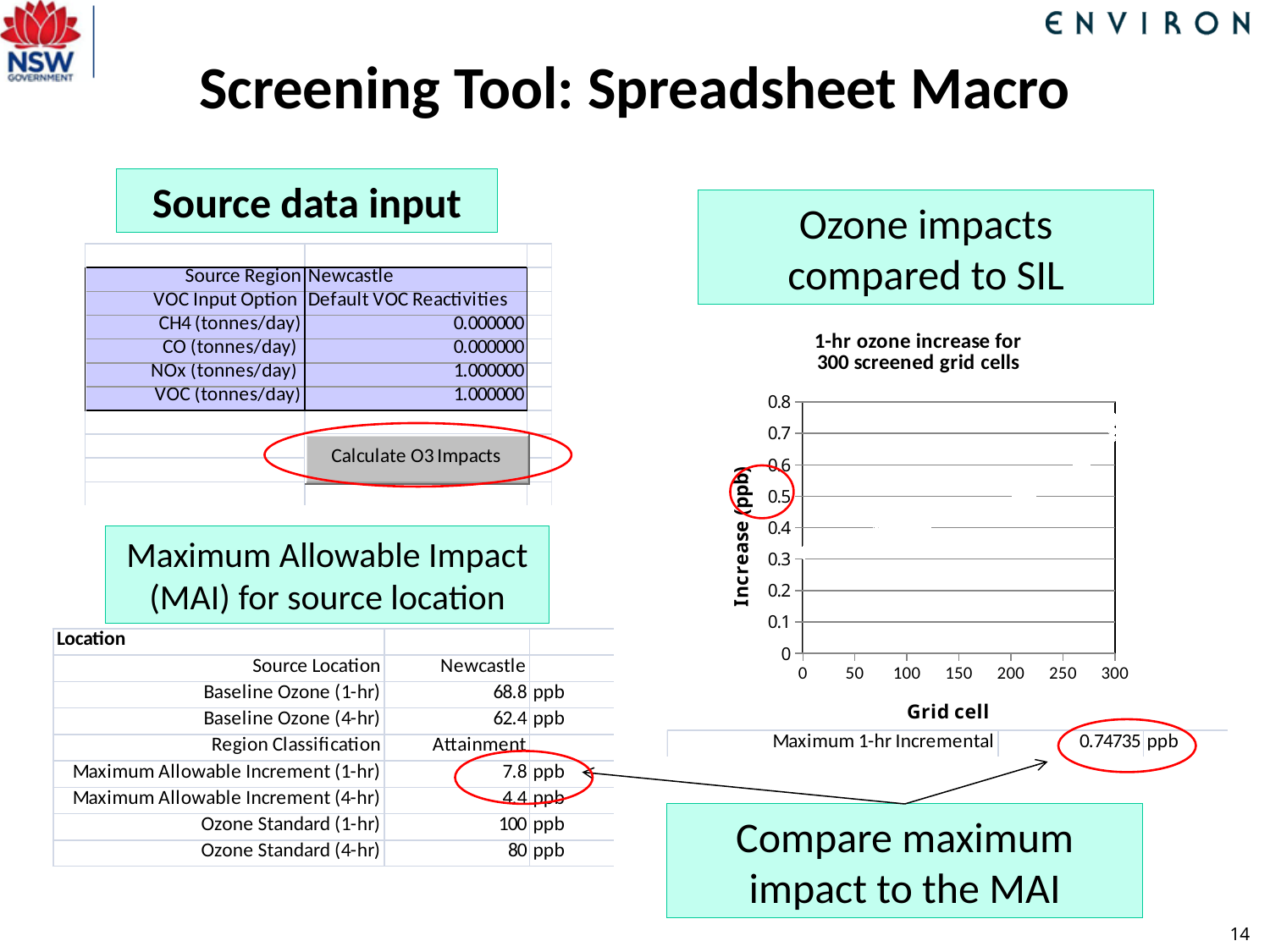
How many screened grid cells does the chart title say are plotted? 300 What is the title of the chart on the right side of the slide? 1-hr ozone increase for 300 screened grid cells Is the Maximum 1-hr Incremental value of 0.74735 ppb greater or less than the Maximum Allowable Increment (1-hr) of 7.8 ppb? less According to the value printed below the chart, what is the Maximum 1-hr Incremental ozone increase? 0.74735 ppb What is the highest value shown on the chart's horizontal axis (Grid cell)? 300 What is the highest value shown on the chart's vertical axis? 0.8 Do the plotted ozone increase values generally rise or fall as the grid cell number increases along the x axis? rise What kind of chart is shown under the heading '1-hr ozone increase for 300 screened grid cells'? scatter chart What is the label of the vertical axis of the chart? Increase (ppb)